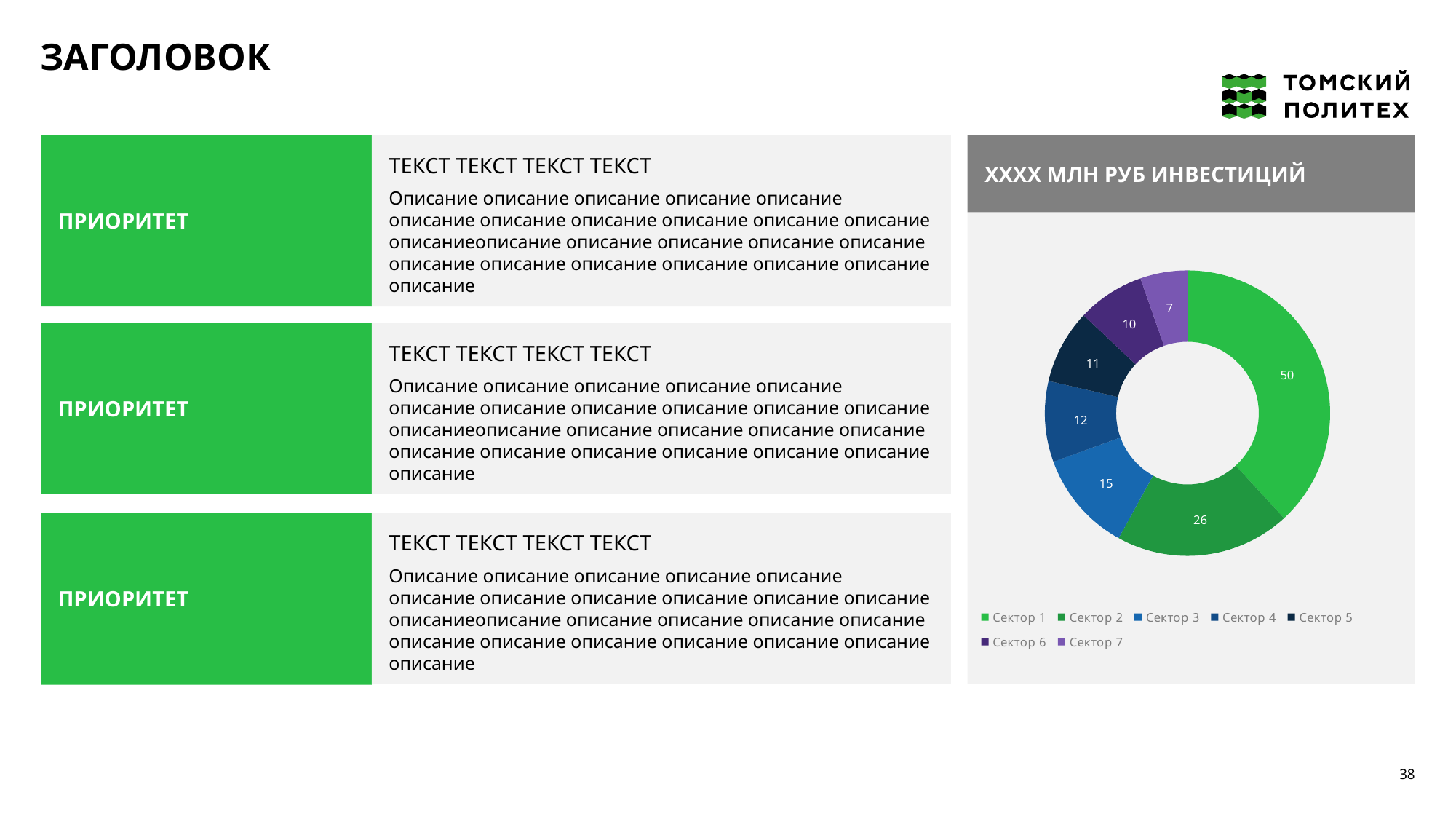
Which sector has the lowest value in the doughnut chart? Сектор 7 What is the value for Сектор 7 in the doughnut chart? 7 What is the title above the doughnut chart? XXXX МЛН РУБ ИНВЕСТИЦИЙ What is the difference between the values for Сектор 3 and Сектор 6? 5 What is the value for Сектор 3 in the doughnut chart? 15 What is the value for Сектор 1 in the doughnut chart? 50 Which sector has the highest value in the doughnut chart? Сектор 1 Which is larger, the value for Сектор 4 or the value for Сектор 6? Сектор 4 What is the difference between the values for Сектор 1 and Сектор 2? 24 What kind of chart is shown on the slide? Doughnut chart What is the value for Сектор 5 in the doughnut chart? 11 How many sectors are shown in the doughnut chart? 7